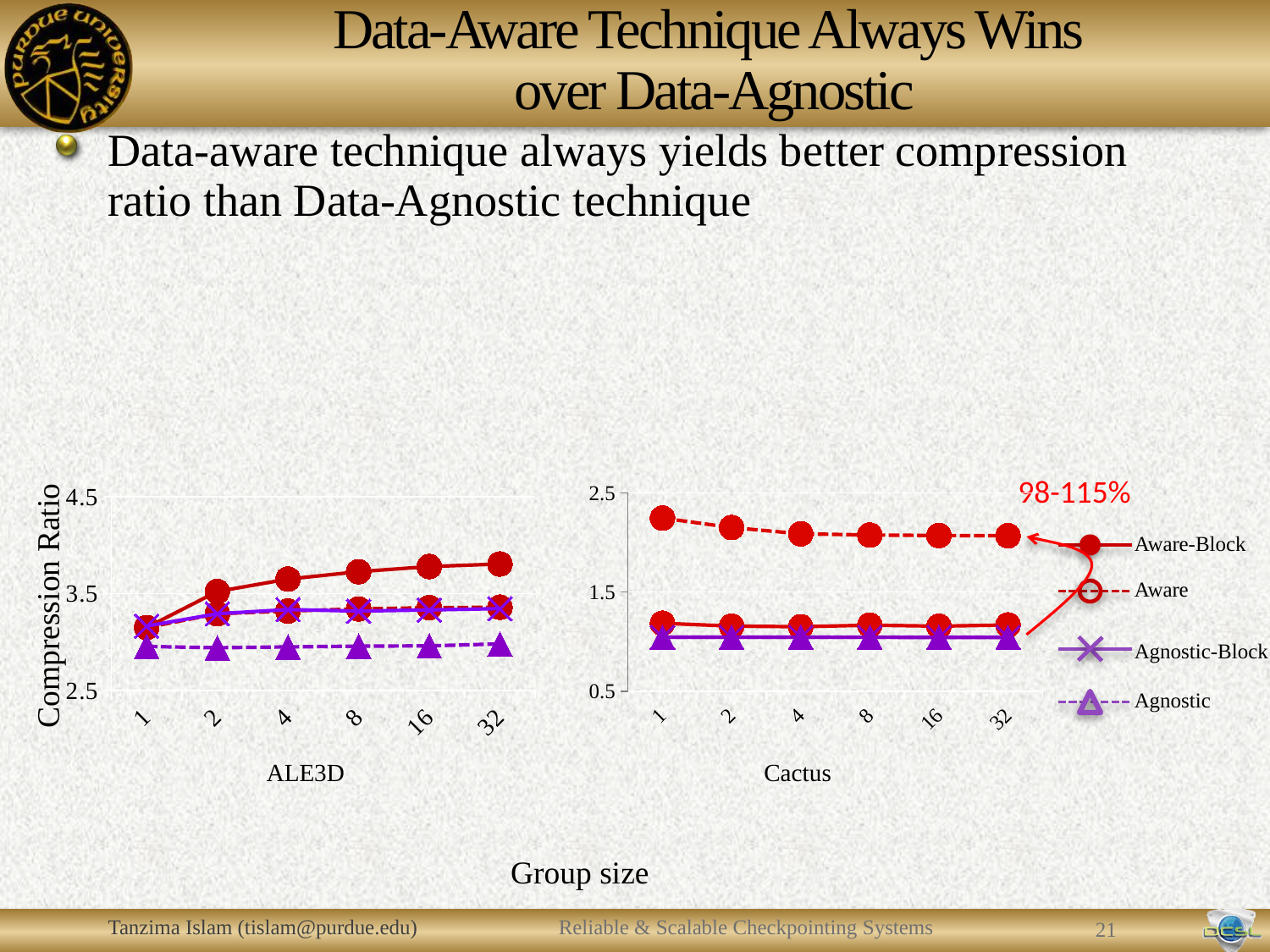
In the ALE3D chart, at group size 32, which is larger: Aware-Block or Agnostic? Aware-Block What is the label on the y axis of the charts? Compression Ratio In the Cactus chart, which series has the highest compression ratio at group size 1? Aware How many series does the legend list for the charts? 4 In the Cactus chart, is the Aware-Block value at group size 1 greater or less than 1.5? less In the ALE3D chart, how many group sizes are shown on the x axis? 6 In the ALE3D chart, is the Agnostic value at group size 1 greater or less than 3.5? less In the ALE3D chart, is the Aware-Block value at group size 32 greater or less than 3.5? greater In the ALE3D chart, does the Aware-Block series rise or fall as group size increases from 1 to 32? Rise What kind of chart is the ALE3D chart on the left? Line chart